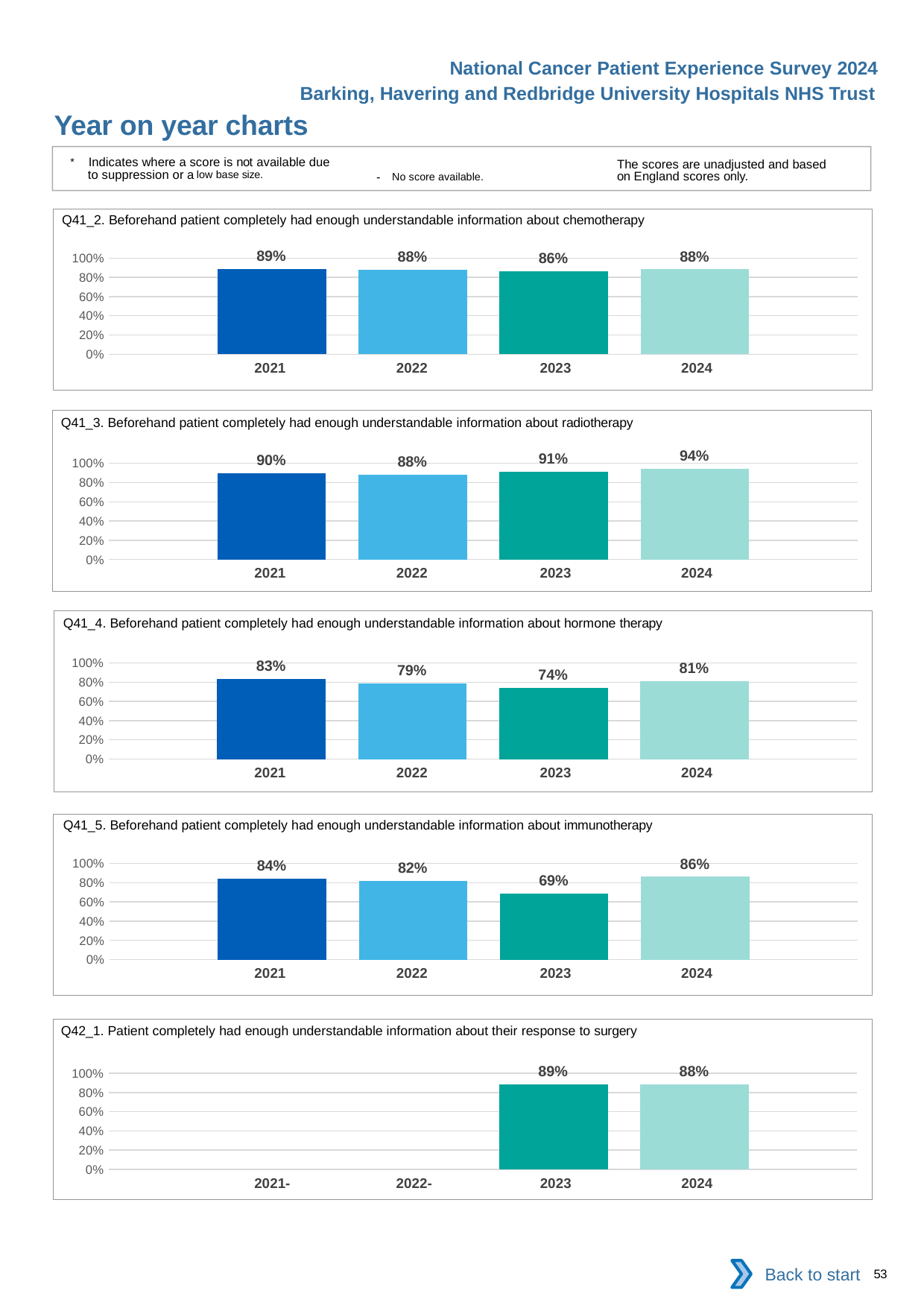
In the Q42_1 chart (response to surgery), which is larger, the value for 2023 or the value for 2024? 2023 In the Q41_4 chart (hormone therapy), which year has the lowest value? 2023 In the Q41_2 chart (chemotherapy), what is the value for 2021? 89% In the Q41_5 chart (immunotherapy), what is the difference between the 2024 value and the 2023 value? 17% What kind of chart is the Q41_3 chart (radiotherapy)? bar chart In the Q41_2 chart (chemotherapy), which year has the lowest value? 2023 How many charts are shown on the slide? 5 In the Q41_3 chart (radiotherapy), which year has the highest value? 2024 In the Q41_4 chart (hormone therapy), what is the value for 2022? 79% In the Q41_3 chart (radiotherapy), what is the difference between the 2024 value and the 2022 value? 6% In the Q41_5 chart (immunotherapy), is the value for 2023 greater or less than 80%? less How many bars with values are plotted in the Q42_1 chart (response to surgery)? 2